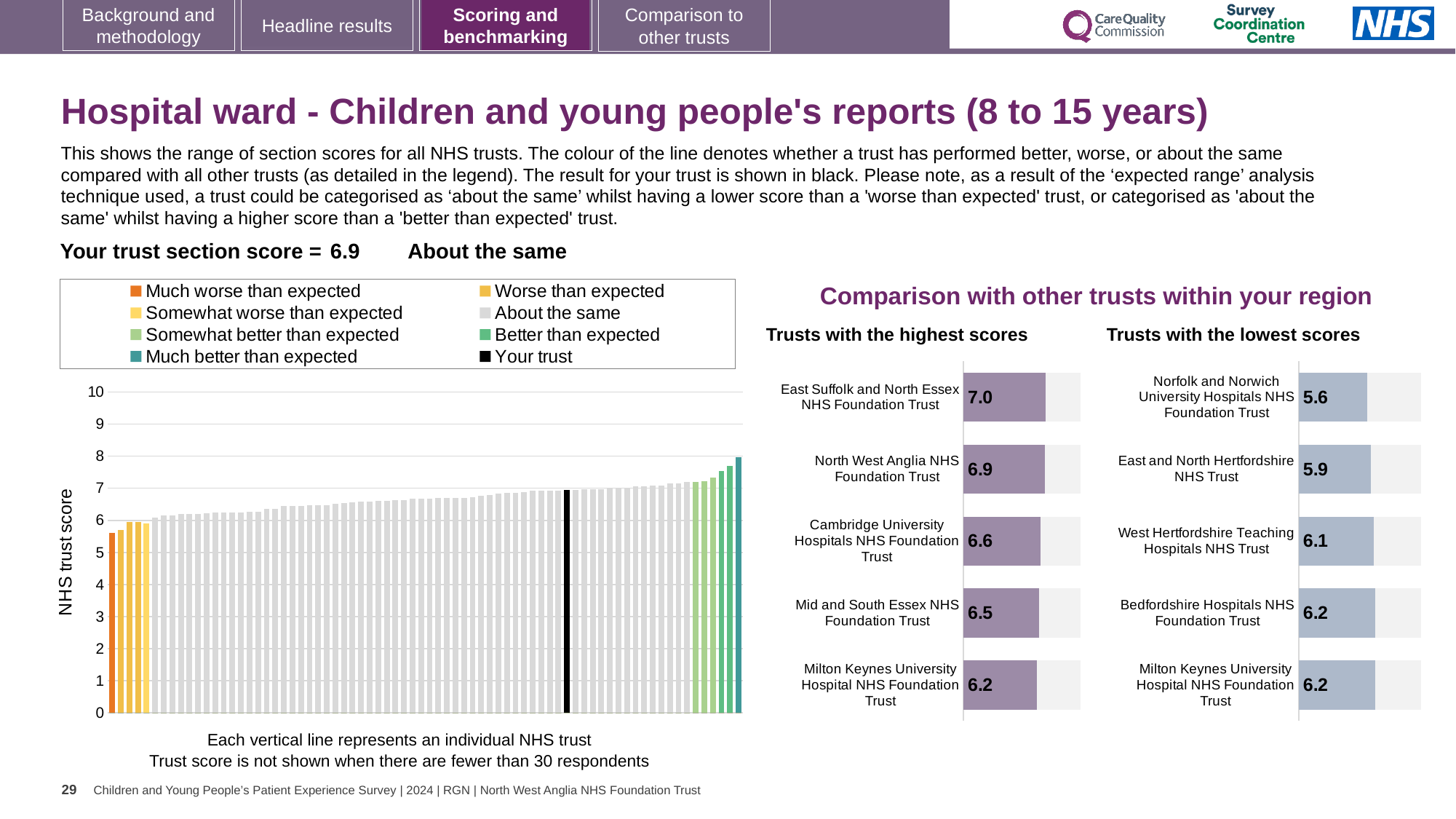
In the 'Trusts with the highest scores' chart, what is the score for Cambridge University Hospitals NHS Foundation Trust? 6.6 In the main 'NHS trust score' chart on the left, is the value for the black 'Your trust' bar greater or less than 6? greater In the 'Trusts with the highest scores' chart, what is the difference between the scores of East Suffolk and North Essex NHS Foundation Trust and Milton Keynes University Hospital NHS Foundation Trust? 0.8 How many trusts are shown in the 'Trusts with the highest scores' chart? 5 In the 'Trusts with the lowest scores' chart, which has the larger score: East and North Hertfordshire NHS Trust or Bedfordshire Hospitals NHS Foundation Trust? Bedfordshire Hospitals NHS Foundation Trust How many entries does the legend of the main 'NHS trust score' chart on the left list? 8 In the 'Trusts with the lowest scores' chart, what is the score for Norfolk and Norwich University Hospitals NHS Foundation Trust? 5.6 In the 'Trusts with the lowest scores' chart, which trust has the lowest score? Norfolk and Norwich University Hospitals NHS Foundation Trust In the 'Trusts with the highest scores' chart, which trust has the highest score? East Suffolk and North Essex NHS Foundation Trust In the 'Trusts with the lowest scores' chart, what is the score for West Hertfordshire Teaching Hospitals NHS Trust? 6.1 In the main 'NHS trust score' chart on the left, do the bar values rise or fall from left to right? rise In the 'Trusts with the highest scores' chart, what is the score for East Suffolk and North Essex NHS Foundation Trust? 7.0